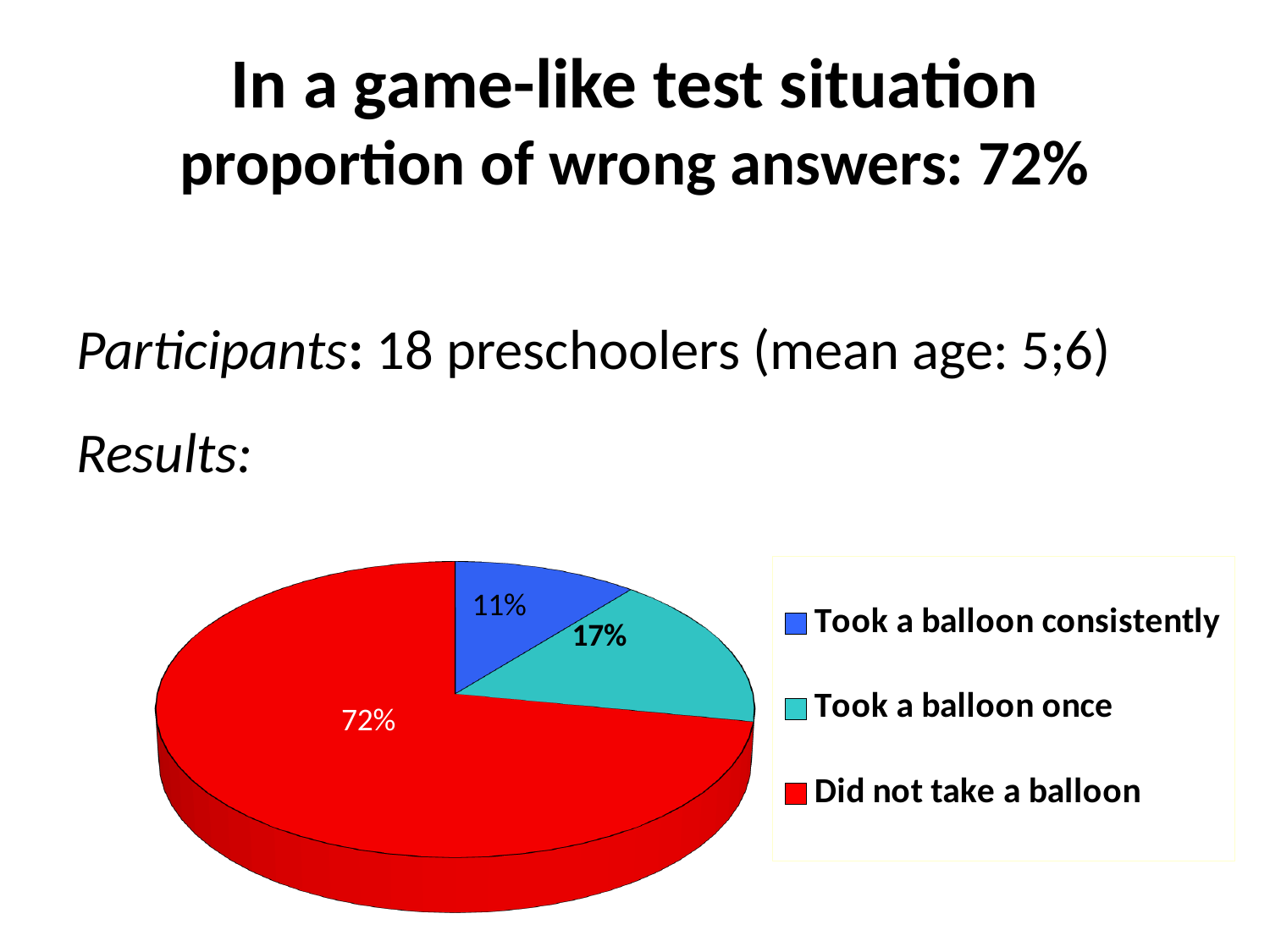
How many entries does the legend list? 3 How many slices does the pie chart have? 3 What is the difference in percentage points between "Took a balloon once" and "Took a balloon consistently"? 6 Which is larger, the share for "Took a balloon once" or the share for "Took a balloon consistently"? Took a balloon once What share of the pie is labelled "Took a balloon once"? 17% Which category has the smallest slice of the pie? Took a balloon consistently What kind of chart is shown on the slide? pie chart What is the difference in percentage points between "Did not take a balloon" and "Took a balloon once"? 55 What share of the pie is labelled "Did not take a balloon"? 72% Which category has the largest slice of the pie? Did not take a balloon What colour is the slice for "Did not take a balloon"? red What share of the pie is labelled "Took a balloon consistently"? 11%